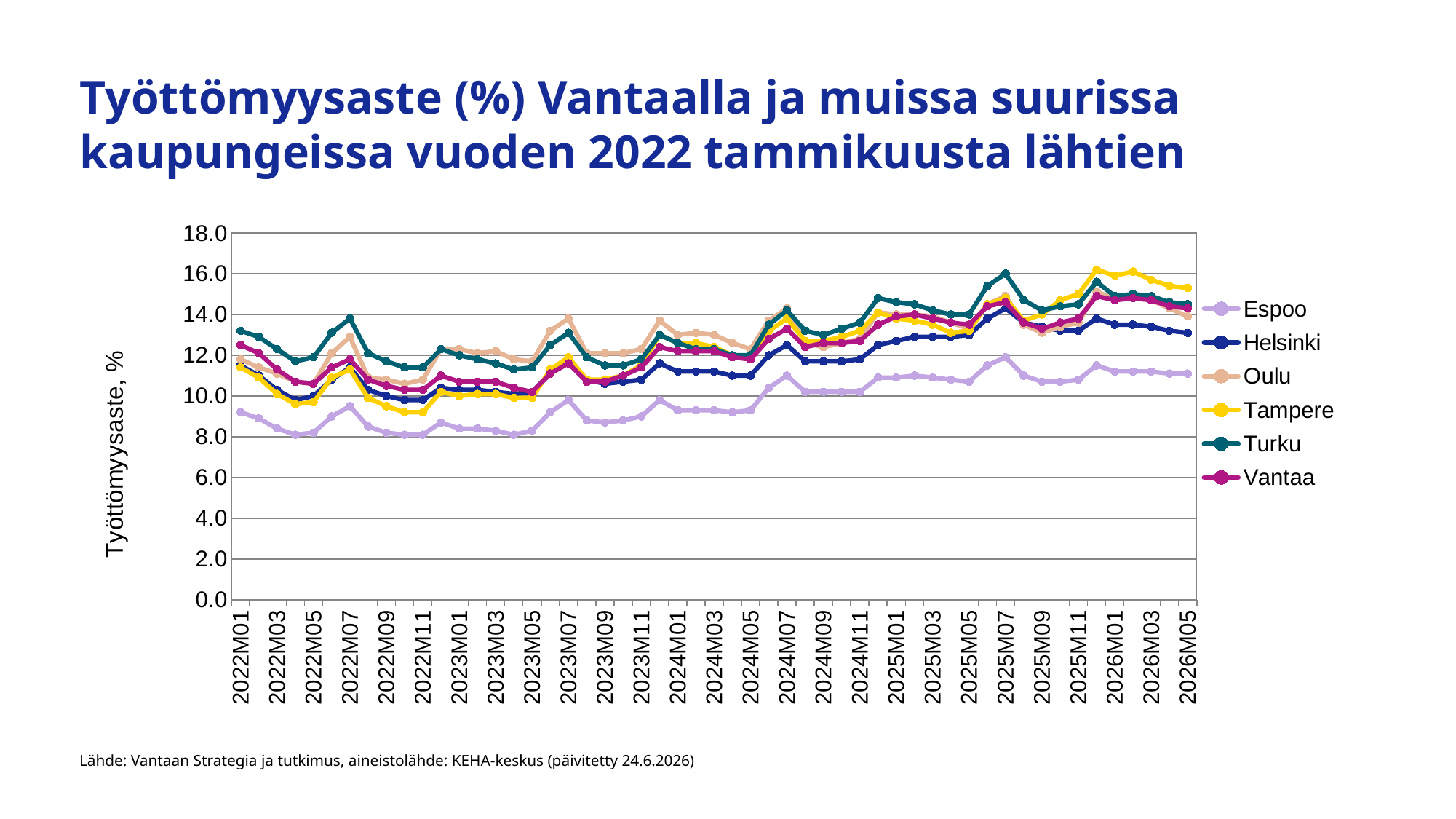
Is the value for Espoo at 2022M01 greater or less than 10? less How many series does the legend list? 6 Is the value for Vantaa at 2026M05 greater or less than 12? greater Is the value for Turku at 2025M07 greater or less than 14? greater What kind of chart is shown on the slide? line chart Which city has the highest unemployment rate at 2025M07? Turku Which city has the lowest unemployment rate throughout the whole period? Espoo What is the label of the vertical axis? Työttömyysaste, % Which cities are listed in the chart legend? Espoo, Helsinki, Oulu, Tampere, Turku, Vantaa At 2025M07, which is larger, the value for Espoo or the value for Turku? Turku Which city has the highest unemployment rate at 2026M01? Tampere Overall, do the unemployment rates rise or fall from 2022M01 to 2026M05? rise